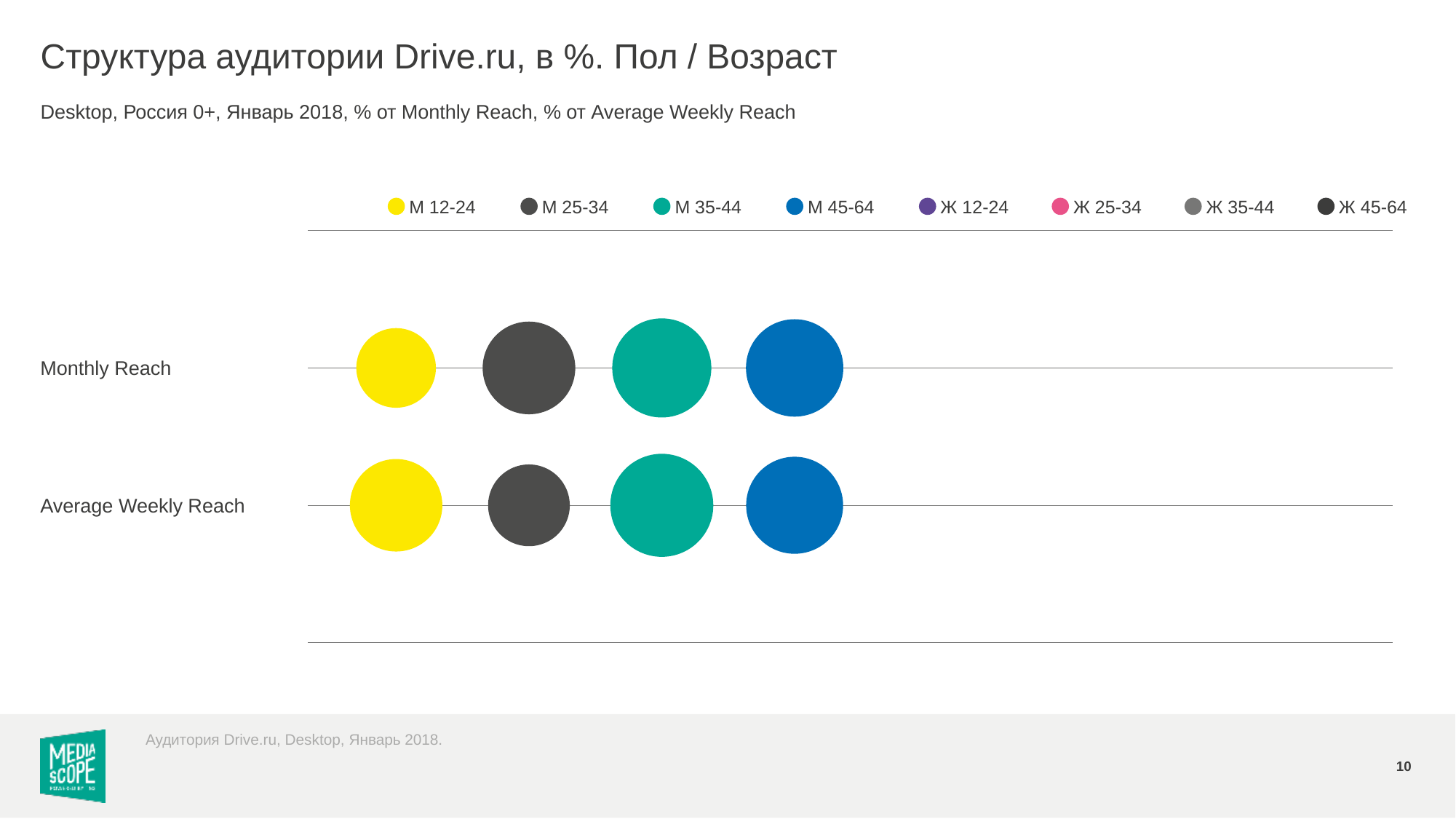
What kind of chart is shown on the slide? Bubble chart In the Monthly Reach row, which of the plotted series has the smallest bubble? М 12-24 In the Monthly Reach row, which bubble is larger: М 12-24 or М 25-34? М 25-34 How many series does the legend list? 8 In the Average Weekly Reach row, which bubble is larger: М 12-24 or М 25-34? М 12-24 Which colour represents the М 12-24 series in the legend? Yellow How many bubbles are visible in the Monthly Reach row? 4 How many rows (categories) are plotted on the chart? 2 What is the title of the chart on the slide? Структура аудитории Drive.ru, в %. Пол / Возраст In the Average Weekly Reach row, which of the plotted series has the smallest bubble? М 25-34